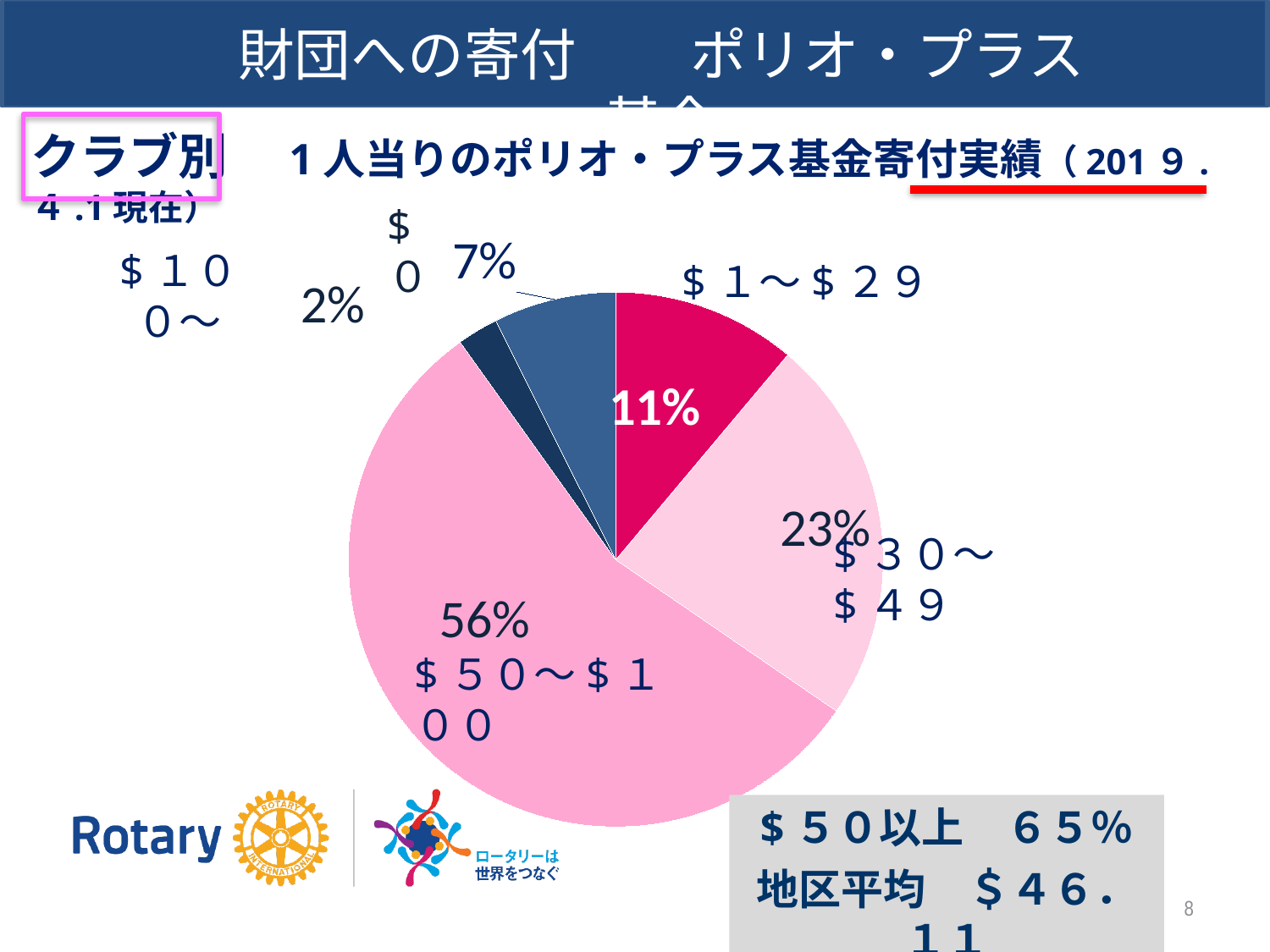
How many slices does the pie chart have? 5 Which slice is larger, $30～$49 or $1～$29? $30～$49 What kind of chart is shown on the slide? pie chart What is the district average (地区平均) donation shown on the slide? ＄４６.１１ According to the box on the slide, what percentage of members donated $50 or more (＄５０以上)? ６５% What percentage of the pie is the $1～$29 slice? 11% What percentage of the pie is the $30～$49 slice? 23% Is the share of the $50～$100 slice greater or less than 50%? greater What percentage of the pie is the $50～$100 slice? 56% What is the smallest percentage shown on the pie chart? 2% What is the difference in percentage points between the $50～$100 slice and the $30～$49 slice? 33 Which category has the largest share of the pie? $50～$100